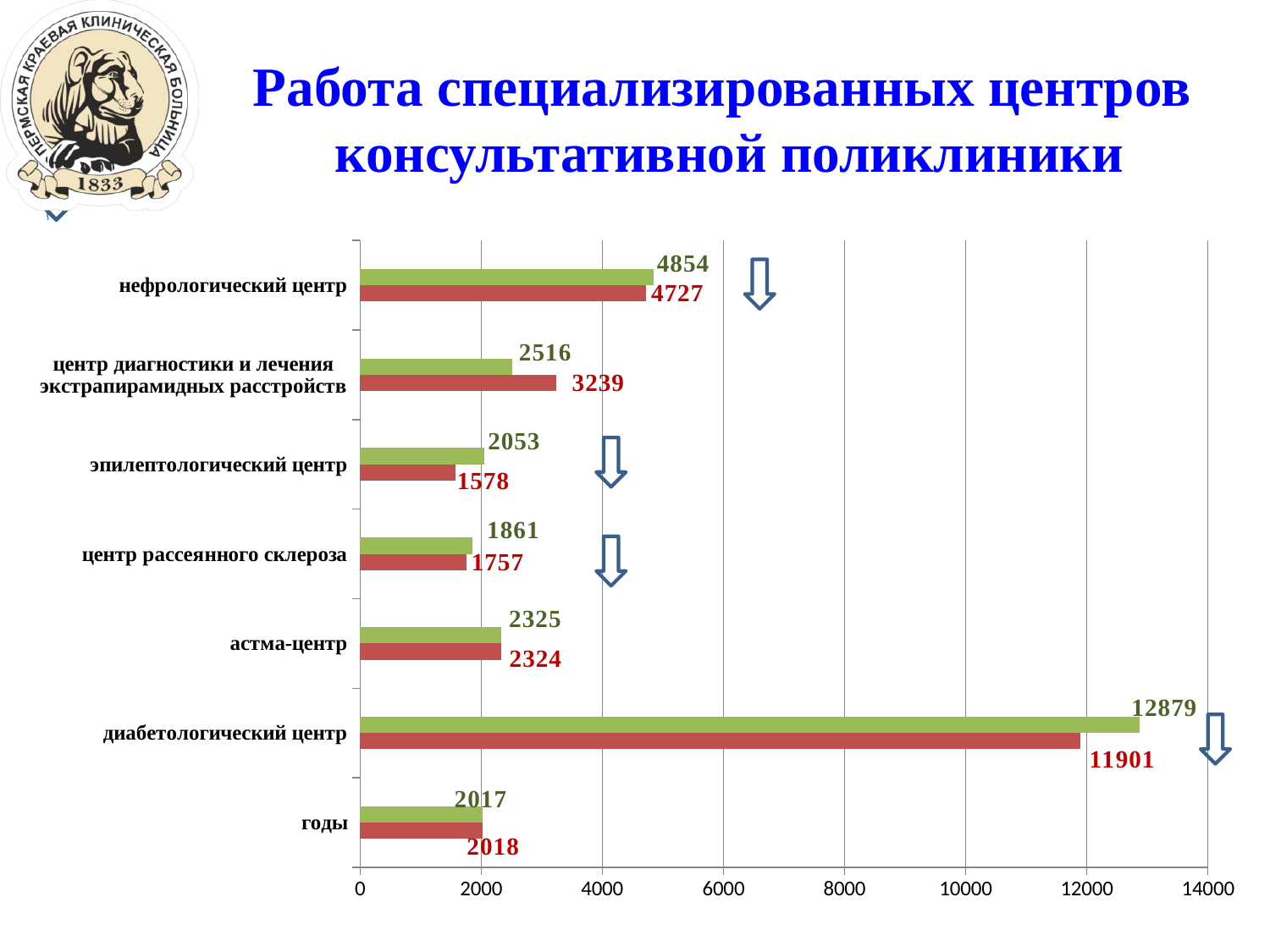
What is the 2017 value (green bar) for диабетологический центр? 12879 What is the difference between the 2018 and 2017 values for центр диагностики и лечения экстрапирамидных расстройств? 723 For центр рассеянного склероза, which is larger: the 2017 value or the 2018 value? 2017 value (1861) What is the 2018 value (red bar) for центр диагностики и лечения экстрапирамидных расстройств? 3239 What is the difference between the 2017 and 2018 values for диабетологический центр? 978 What is the 2018 value (red bar) for эпилептологический центр? 1578 What kind of chart is shown on the slide? bar chart Which colour represents the year 2018 on the chart? red Which centre has the highest 2018 value (red bar)? диабетологический центр Which centre has the lowest 2018 value (red bar)? эпилептологический центр How many specialized centres are plotted on the chart (excluding the годы row)? 6 What is the 2017 value (green bar) for нефрологический центр? 4854